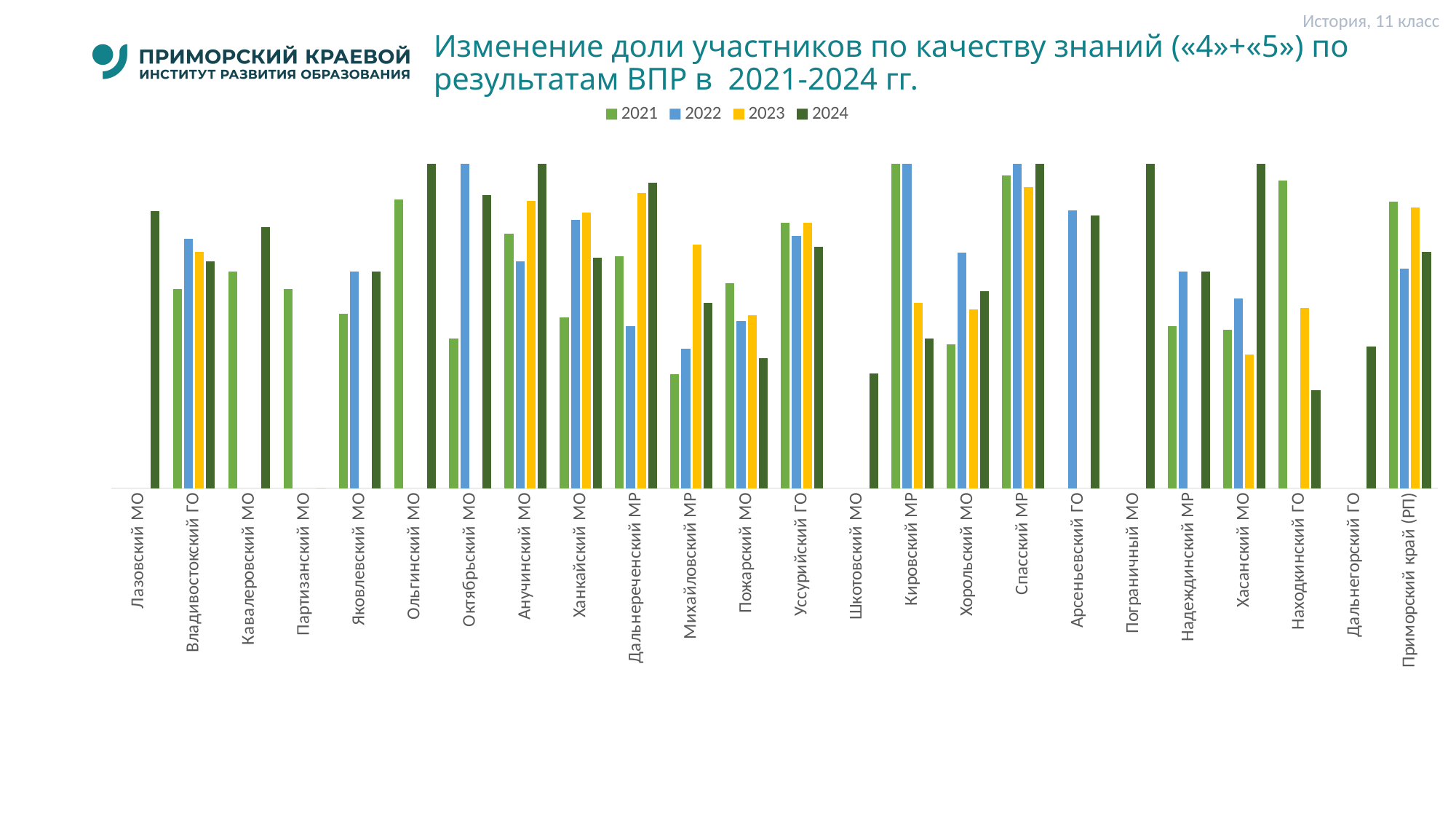
For Находкинский ГО, which is larger: the 2021 value or the 2024 value? 2021 For Пожарский МО, which year has the lowest bar? 2024 For Хасанский МО, which is larger: the 2023 value or the 2024 value? 2024 For Октябрьский МО, which year has the lowest bar? 2021 How many categories (municipalities) are shown on the x axis? 24 For Находкинский ГО, which year has the lowest bar? 2024 How many series does the legend list? 4 Which subject and grade are indicated in the top right corner of the slide? История, 11 класс For Михайловский МР, which year has the highest bar? 2023 Which years are listed in the legend? 2021, 2022, 2023, 2024 What kind of chart is shown on the slide? bar chart For Октябрьский МО, which year has the highest bar? 2022